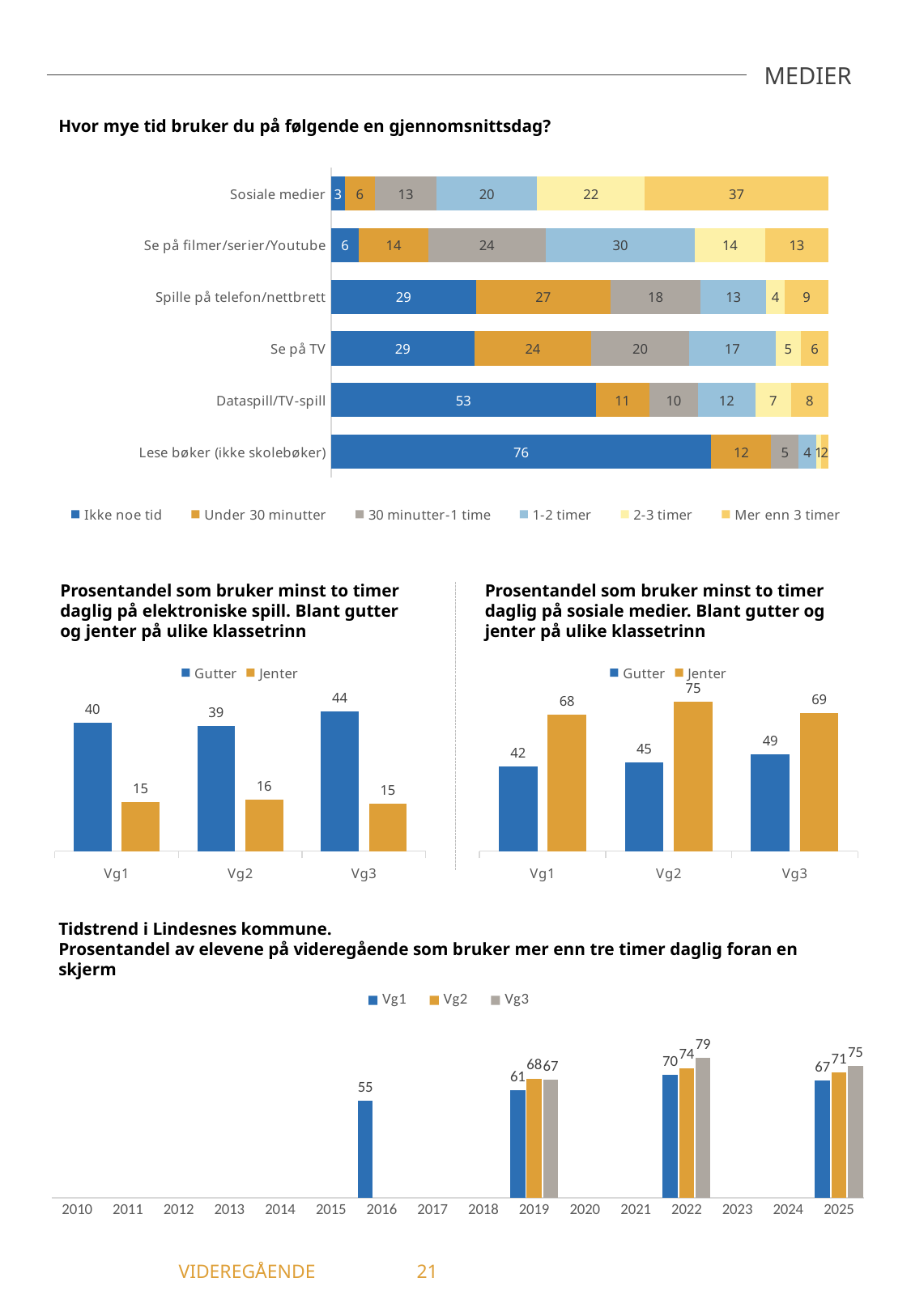
In the chart 'Prosentandel som bruker minst to timer daglig på sosiale medier', which class level has the highest value for Jenter? Vg2 In the chart 'Hvor mye tid bruker du på følgende en gjennomsnittsdag?', what is the value for 'Mer enn 3 timer' for 'Sosiale medier'? 37 In the chart 'Hvor mye tid bruker du på følgende en gjennomsnittsdag?', which category has the highest value for 'Ikke noe tid'? Lese bøker (ikke skolebøker) In the chart 'Prosentandel som bruker minst to timer daglig på sosiale medier', what is the value for Gutter at Vg1? 42 In the chart 'Tidstrend i Lindesnes kommune', what is the difference between Vg3 and Vg1 in 2025? 8 In the chart 'Prosentandel som bruker minst to timer daglig på sosiale medier', which is larger at Vg3, Gutter or Jenter? Jenter In the chart 'Prosentandel som bruker minst to timer daglig på elektroniske spill', what is the difference between Gutter and Jenter at Vg1? 25 In the chart 'Tidstrend i Lindesnes kommune', what is the value for Vg3 in 2022? 79 In the chart 'Hvor mye tid bruker du på følgende en gjennomsnittsdag?', what is the value for '1-2 timer' for 'Se på filmer/serier/Youtube'? 30 In the chart 'Hvor mye tid bruker du på følgende en gjennomsnittsdag?', how many series does the legend list? 6 What kind of chart is 'Tidstrend i Lindesnes kommune'? Bar chart In the chart 'Prosentandel som bruker minst to timer daglig på elektroniske spill', what is the value for Gutter at Vg3? 44